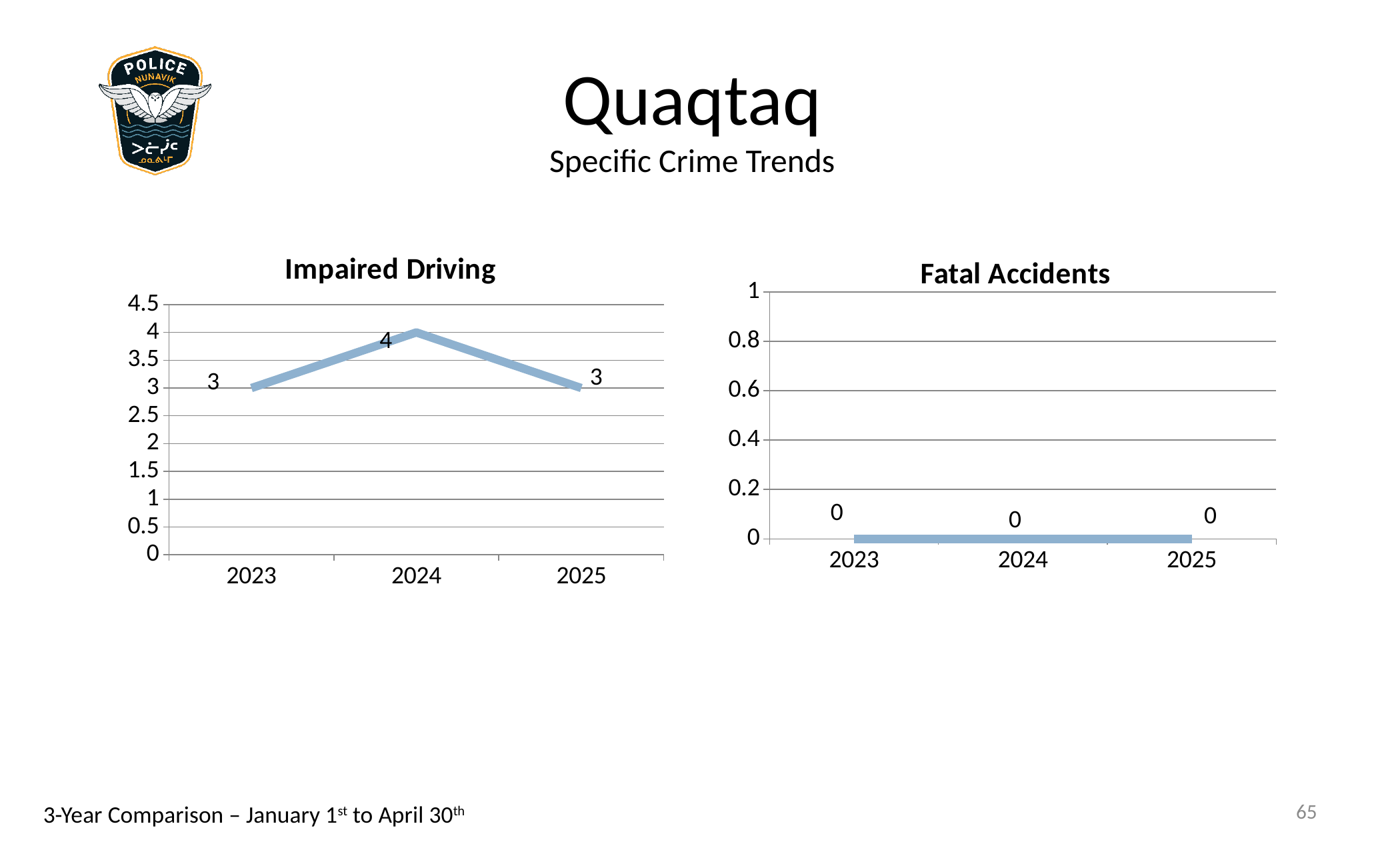
In the Impaired Driving chart, what is the value for 2023? 3 In the Impaired Driving chart, which year has the highest value? 2024 In the Fatal Accidents chart, what is the total of the values for 2023, 2024 and 2025? 0 What kind of chart is the Impaired Driving chart? line chart In the Impaired Driving chart, what is the value for 2024? 4 In the Impaired Driving chart, do the values rise or fall from 2024 to 2025? fall In the Impaired Driving chart, what is the difference between the 2024 value and the 2025 value? 1 In the Fatal Accidents chart, what is the highest value shown on the y axis? 1 What is the title of the chart on the right side of the slide? Fatal Accidents In the Impaired Driving chart, how many years are plotted? 3 In the Fatal Accidents chart, what is the value for 2025? 0 In the Impaired Driving chart, is the value for 2024 greater or less than 3.5? greater